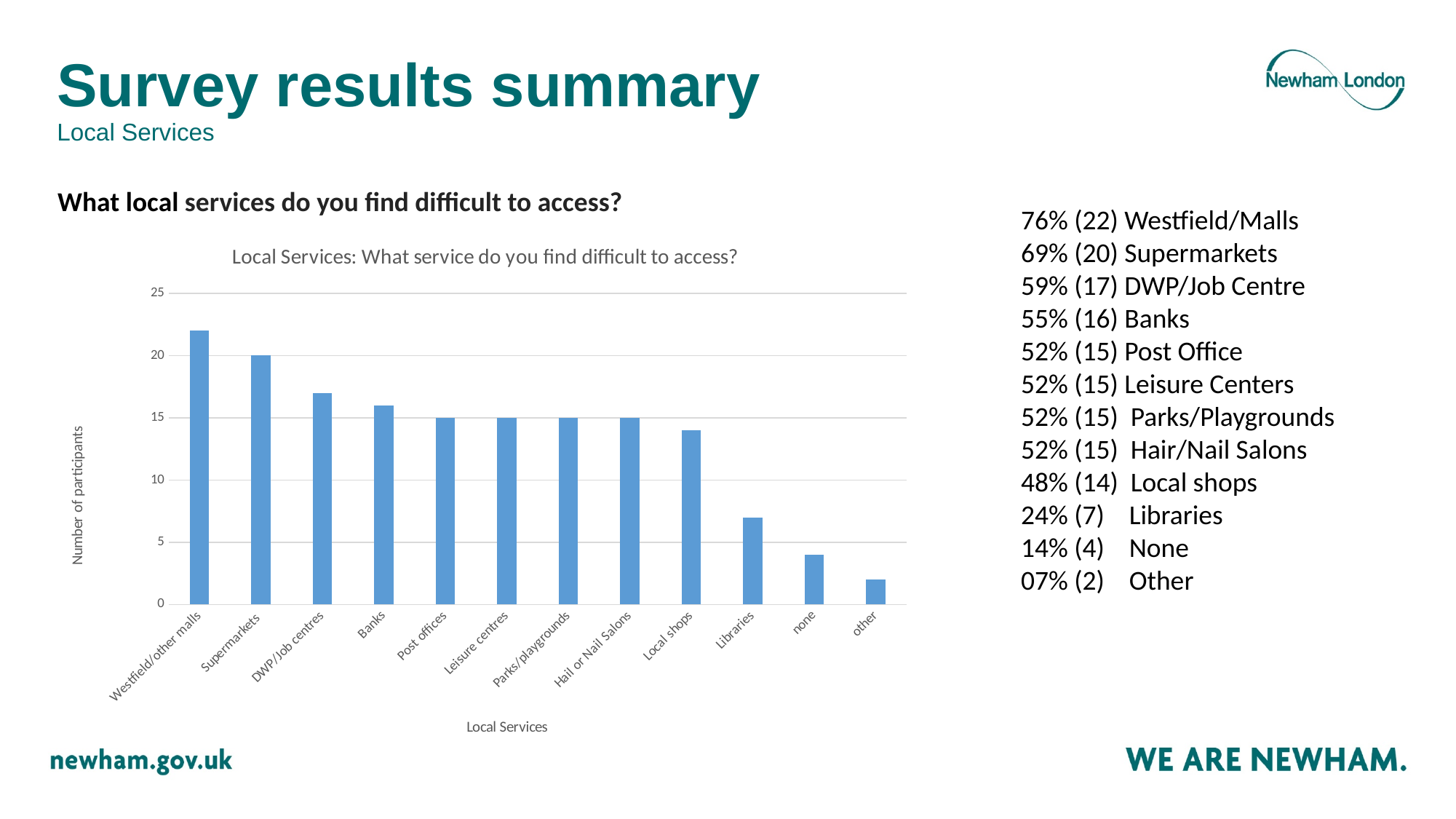
Is the value for DWP/Job centres greater or less than 15? greater What is the number of participants for Westfield/other malls? 22 What is the number of participants for Supermarkets? 20 Which has more participants, Supermarkets or Banks? Supermarkets Which local service has the highest number of participants in the chart? Westfield/other malls How many local service categories are plotted on the x axis of the chart? 12 Is the value for Libraries greater or less than 10? less Which category has the lowest bar in the chart? other What is the label of the chart's y axis? Number of participants What kind of chart is shown on the slide? bar chart Do the bar values rise or fall from left to right along the x axis? fall What is the number of participants for Post offices? 15